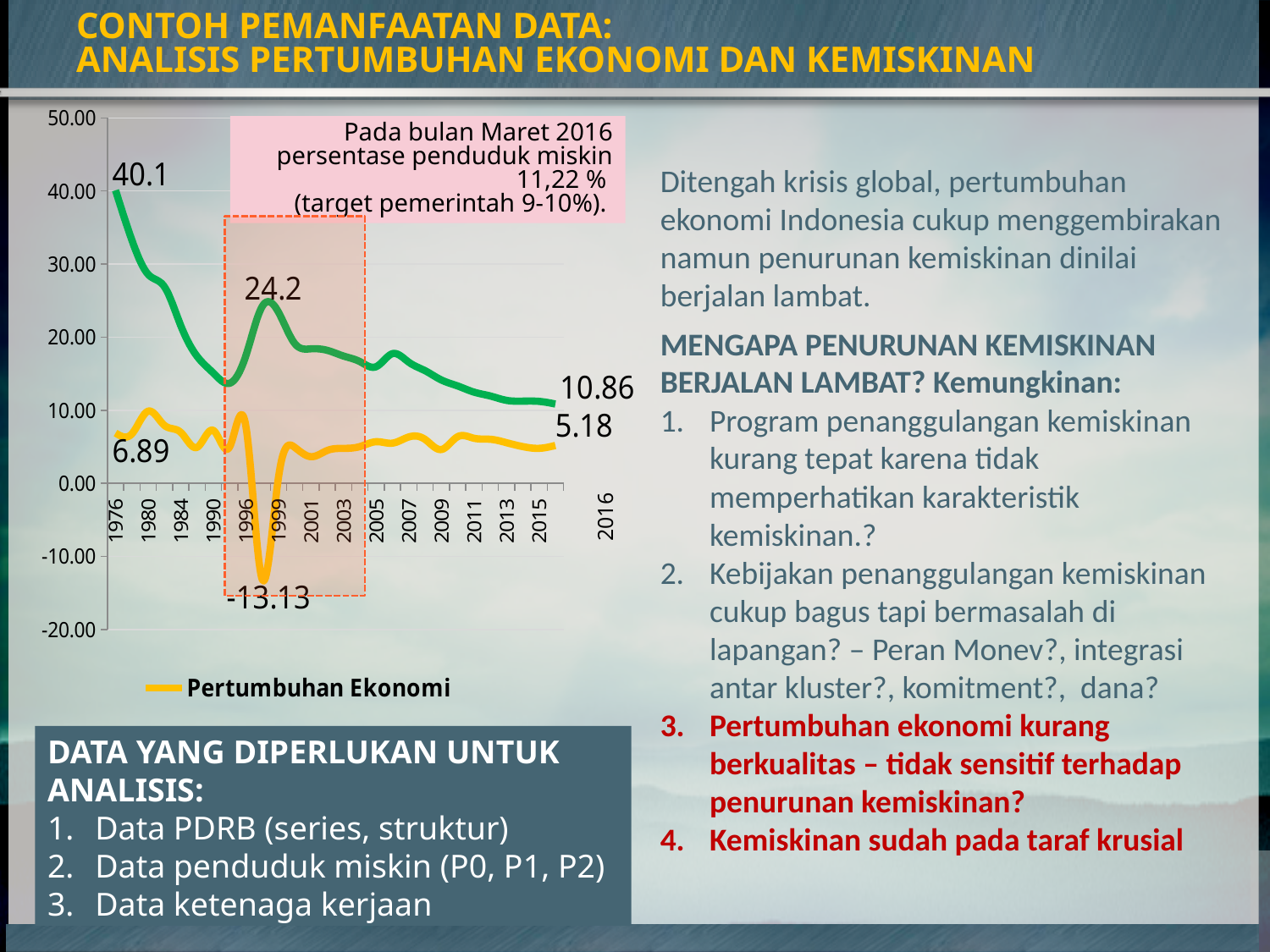
What is the first labelled value of the Pertumbuhan Ekonomi line, at 1976? 6.89 What is the last labelled value of the Pertumbuhan Ekonomi line, at the right end of the chart? 5.18 What is the first labelled value of the green line, at 1976? 40.1 What is the lowest labelled value of the Pertumbuhan Ekonomi line? -13.13 Does the green line generally rise or fall from 1976 to 2015? Fall What kind of chart is shown on the slide? Line chart By how much does the green line fall from its first labelled value (40.1) to its last labelled value (10.86)? 29.24 At the right end of the chart, which is larger: the green line's value (10.86) or the Pertumbuhan Ekonomi value (5.18)? The green line (10.86) What is the name of the series listed in the chart legend? Pertumbuhan Ekonomi What is the labelled peak value of the green line around 1999? 24.2 What is the last labelled value of the green line, at the right end of the chart? 10.86 How many series does the chart legend list? 1